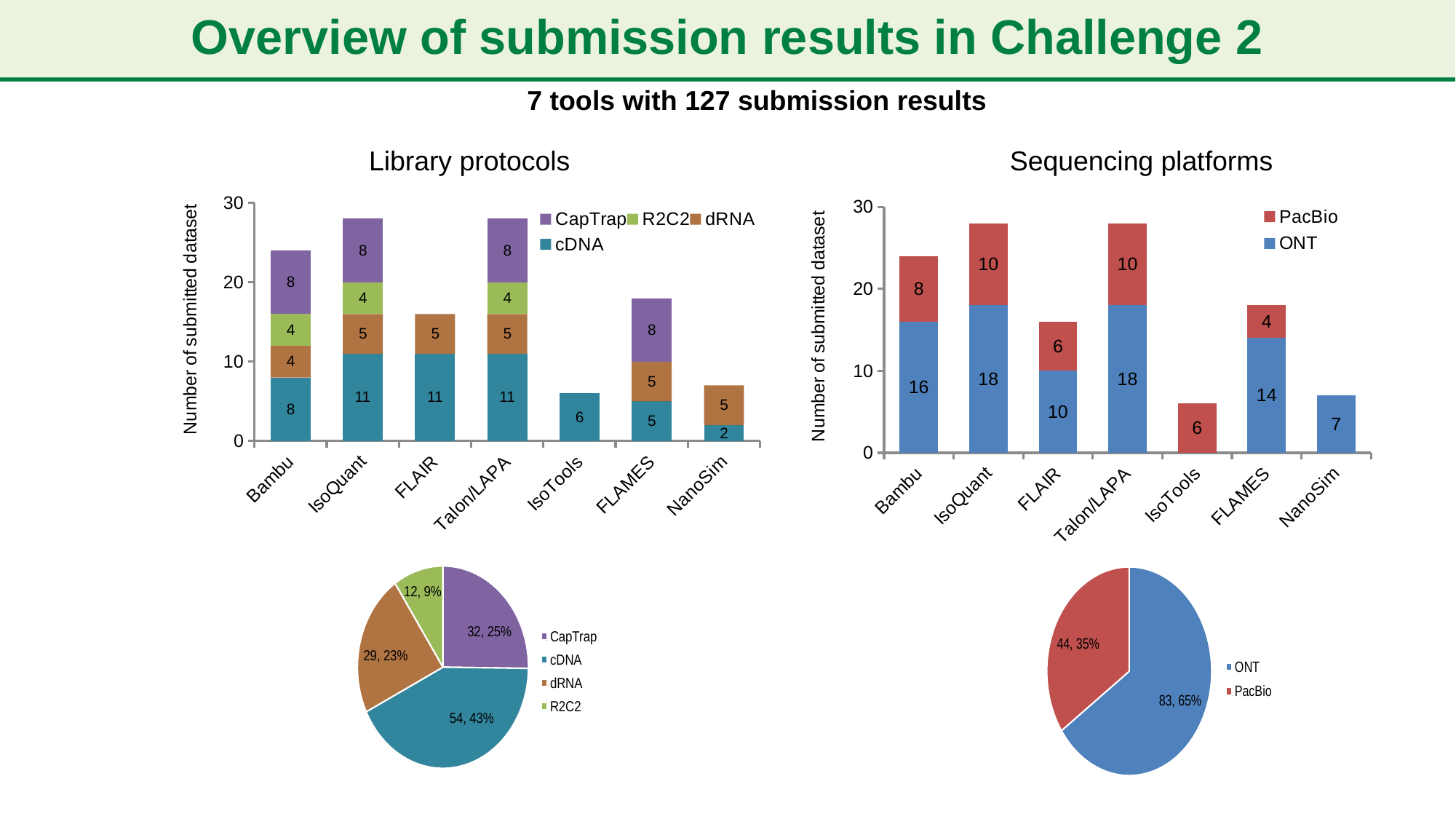
In the Sequencing platforms bar chart, is the ONT value for Bambu larger or the ONT value for FLAIR? Bambu In the bottom-right pie chart, what is the value shown for PacBio? 44, 35% In the Sequencing platforms bar chart, what is the ONT value for FLAMES? 14 How many tools are shown on the x axis of the Sequencing platforms bar chart? 7 In the Sequencing platforms bar chart, what is the total of the stacked bar for Bambu? 24 In the bottom-left pie chart, what share does cDNA have? 43% In the Sequencing platforms bar chart, what is the difference between the ONT and PacBio values for IsoQuant? 8 In the Library protocols bar chart, what is the total of the stacked bar for FLAMES? 18 In the Library protocols bar chart, which tool has the lowest total stacked bar? IsoTools In the Library protocols bar chart, what is the cDNA value for IsoQuant? 11 What kind of chart is the Sequencing platforms chart at the top right? Stacked bar chart How many series does the legend of the Library protocols bar chart list? 4